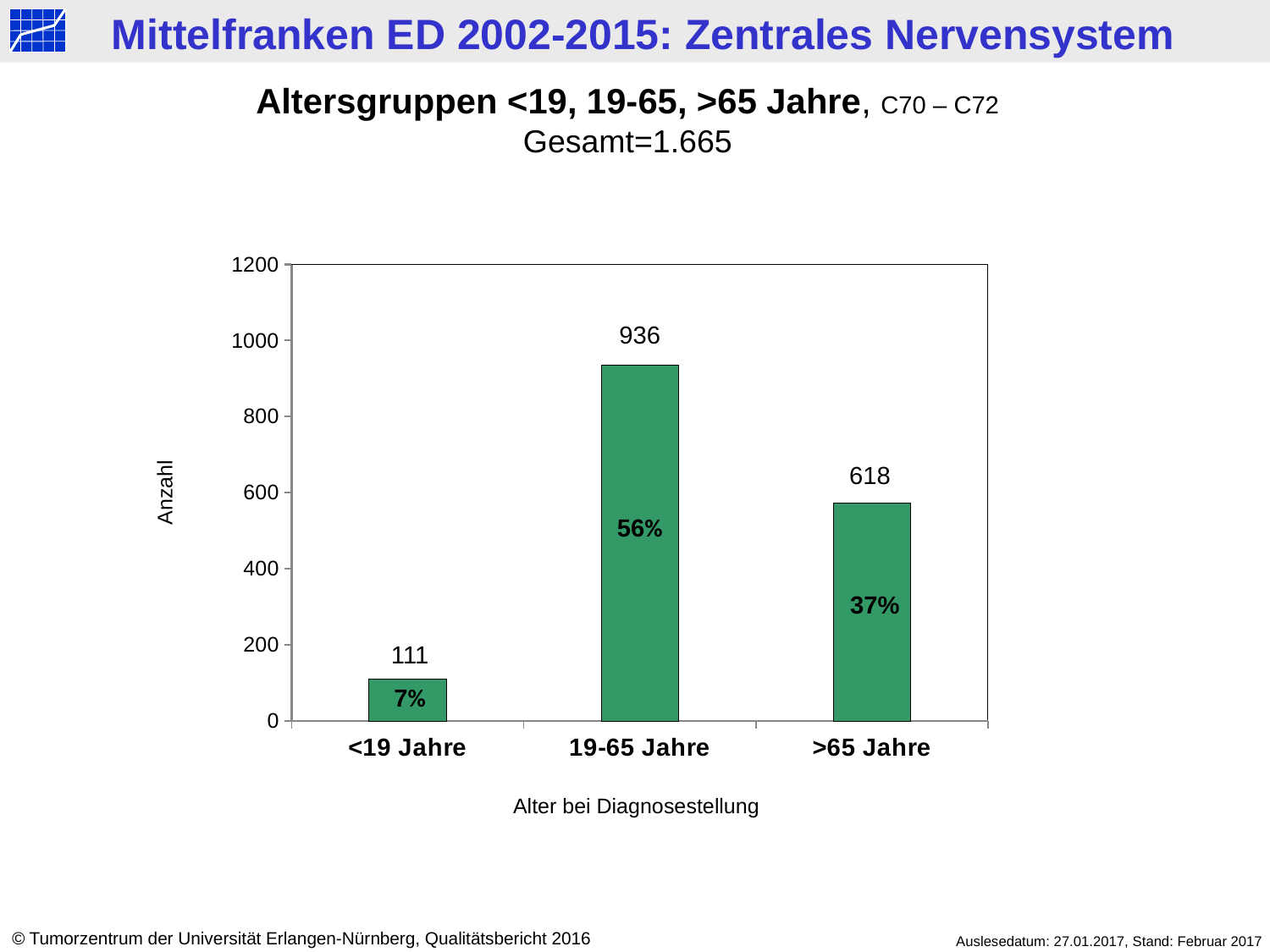
Which age group has the highest value? 19-65 Jahre Which age group has the lowest value? <19 Jahre What is the difference between the values for 19-65 Jahre and >65 Jahre? 318 What is the value for the <19 Jahre age group? 111 What is the value for the 19-65 Jahre age group? 936 What kind of chart is shown on the slide? bar chart How many age groups are shown on the x axis? 3 What is the value for the >65 Jahre age group? 618 What percentage share is shown for the >65 Jahre bar? 37% Which is larger, the value for >65 Jahre or the value for <19 Jahre? >65 Jahre What percentage share is shown for the <19 Jahre bar? 7% What is the label of the y axis? Anzahl